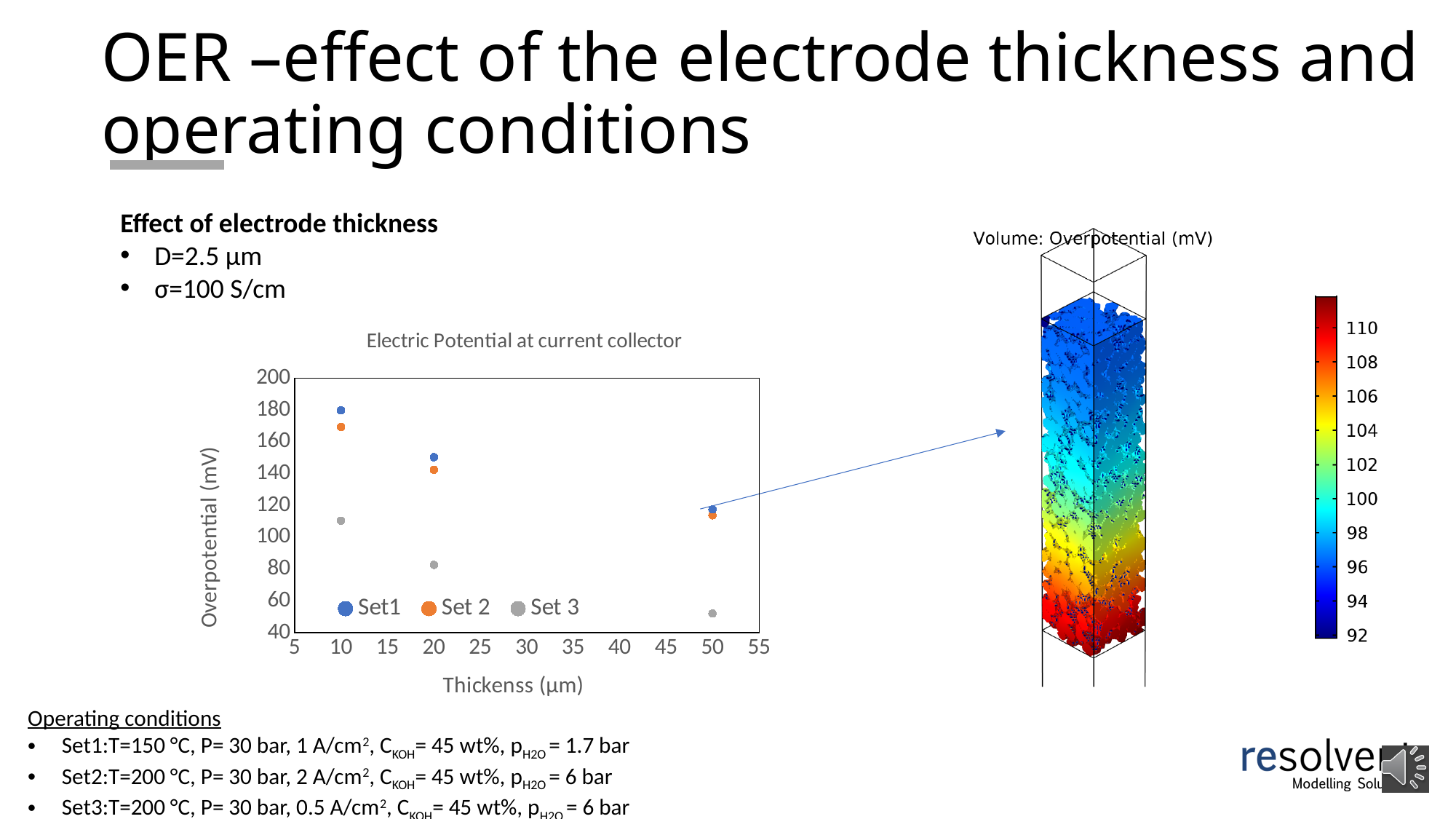
In the "Electric Potential at current collector" chart, is the Set 3 value at a thickness of 50 µm greater or less than 60 mV? less In the "Electric Potential at current collector" chart, which series has the lowest overpotential at a thickness of 20 µm? Set 3 In the "Electric Potential at current collector" chart, which is larger at a thickness of 10 µm: the Set 2 value or the Set 3 value? Set 2 How many data points are plotted for Set 3 in the "Electric Potential at current collector" chart? 3 What are the series names in the legend of the "Electric Potential at current collector" chart? Set1, Set 2, Set 3 What kind of chart is "Electric Potential at current collector"? scatter chart What is the label of the x axis of the "Electric Potential at current collector" chart? Thickenss (µm) In the "Electric Potential at current collector" chart, which series has the highest overpotential at a thickness of 10 µm? Set1 In the "Electric Potential at current collector" chart, does the overpotential for Set1 rise or fall as thickness increases? fall In the "Electric Potential at current collector" chart, is the Set1 value at a thickness of 10 µm greater or less than 160 mV? greater In the "Electric Potential at current collector" chart, is the Set 2 value at a thickness of 20 µm greater or less than 160 mV? less How many series does the legend of the "Electric Potential at current collector" chart list? 3